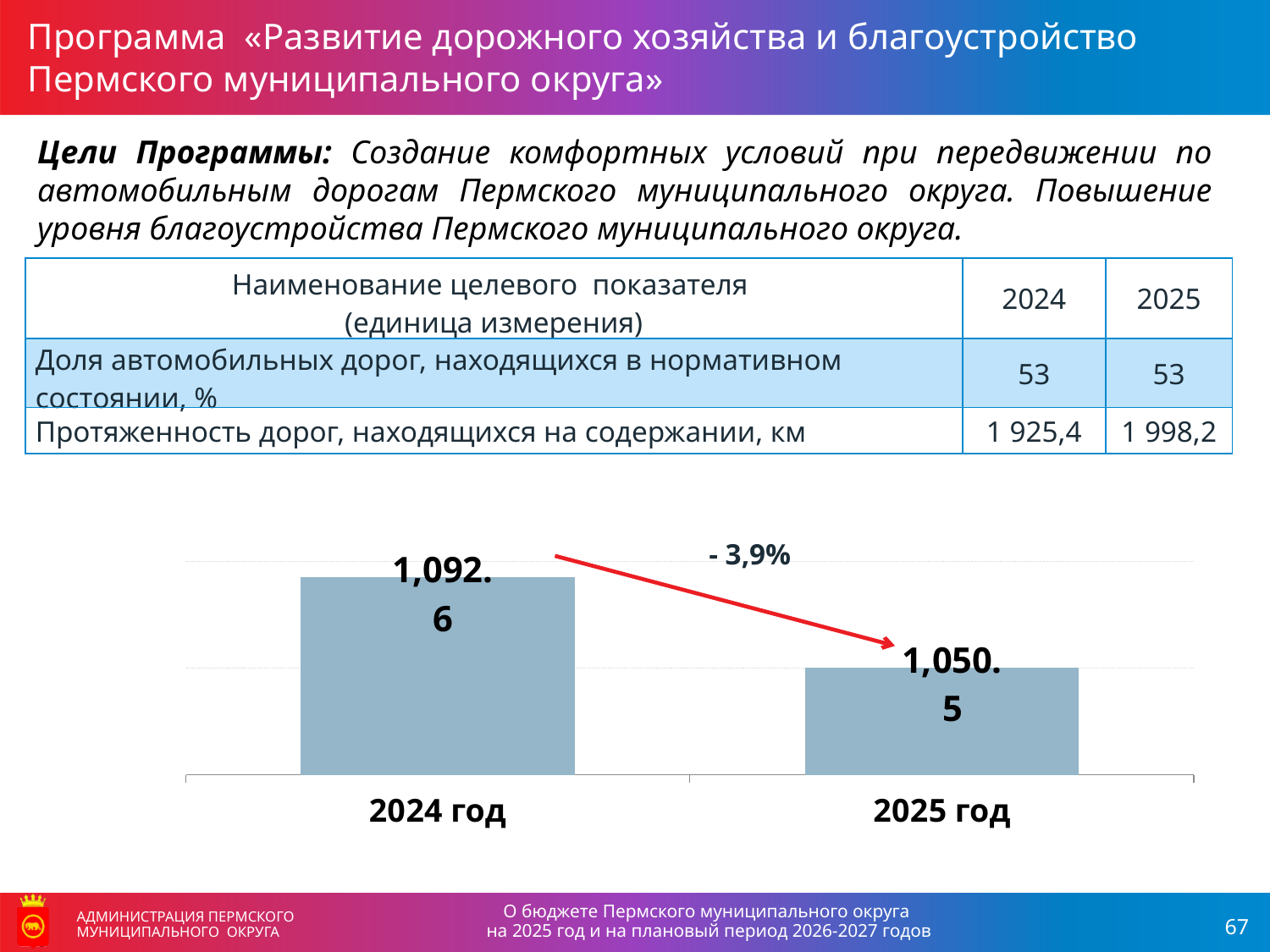
What is the value shown for 2024 год in the bar chart? 1,092.6 How many bars are plotted in the chart? 2 What percentage change is written next to the arrow between the two bars? - 3,9% What colour are the bars in the chart? grey-blue What is the difference between the 2024 год and 2025 год values in the bar chart? 42.1 Do the values rise or fall from 2024 год to 2025 год? fall What type of chart is shown on the slide? bar chart Which year has the higher bar in the chart? 2024 год Which year has the lower bar in the chart? 2025 год Is the value for 2024 год larger or smaller than the value for 2025 год? larger What is the value shown for 2025 год in the bar chart? 1,050.5